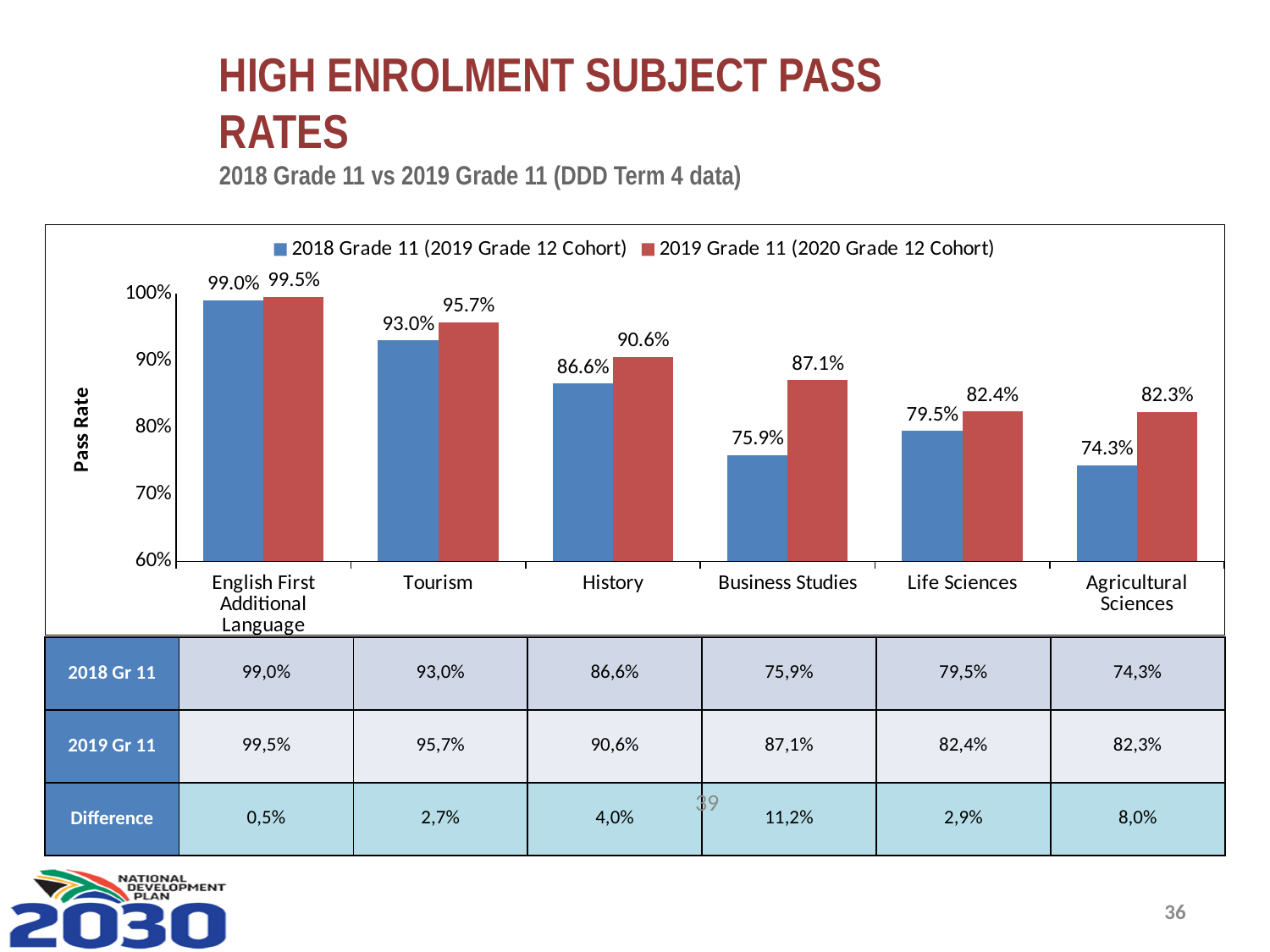
What is the difference between the 2019 Grade 11 and 2018 Grade 11 pass rates for Business Studies? 11.2% Which subject has the lowest 2018 Grade 11 pass rate? Agricultural Sciences What is the 2018 Grade 11 pass rate for History? 86.6% What kind of chart is shown on the slide? Bar chart How many subjects are shown on the chart? 6 What is the 2019 Grade 11 pass rate for Business Studies? 87.1% What is the 2019 Grade 11 pass rate for Agricultural Sciences? 82.3% Which is larger: the 2018 Grade 11 pass rate for Business Studies or for Life Sciences? Life Sciences How many series does the legend list? 2 Is the 2018 Grade 11 pass rate for Agricultural Sciences greater or less than 80%? less Which subject has the highest 2019 Grade 11 pass rate? English First Additional Language What is the difference between the 2019 Grade 11 and 2018 Grade 11 pass rates for Tourism? 2.7%